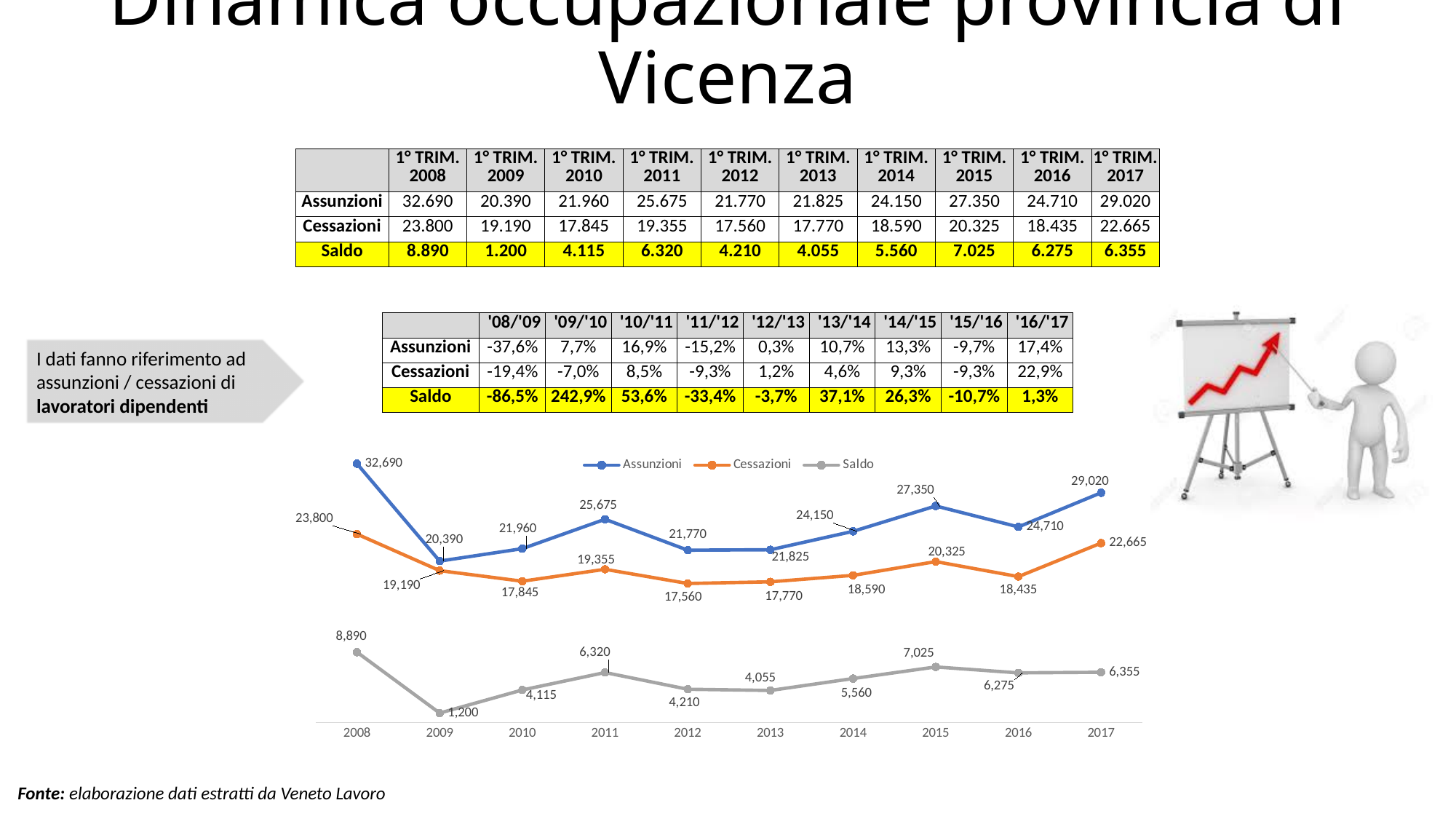
Which colour is used for the Cessazioni series in the chart? Orange In which year is the Assunzioni series at its highest on the chart? 2008 What is the value of Assunzioni in 2008 on the chart? 32,690 Does the Assunzioni series rise or fall between 2016 and 2017 on the chart? Rise What is the value of Cessazioni in 2017 on the chart? 22,665 What type of chart is shown on the slide? Line chart How many series does the chart legend list? 3 Which is larger on the chart: Cessazioni in 2015 or Cessazioni in 2016? Cessazioni in 2015 How many years are plotted along the x axis of the chart? 10 In which year is the Saldo series at its lowest on the chart? 2009 What is the value of Saldo in 2015 on the chart? 7,025 What is the difference between Assunzioni and Cessazioni in 2011 on the chart? 6,320